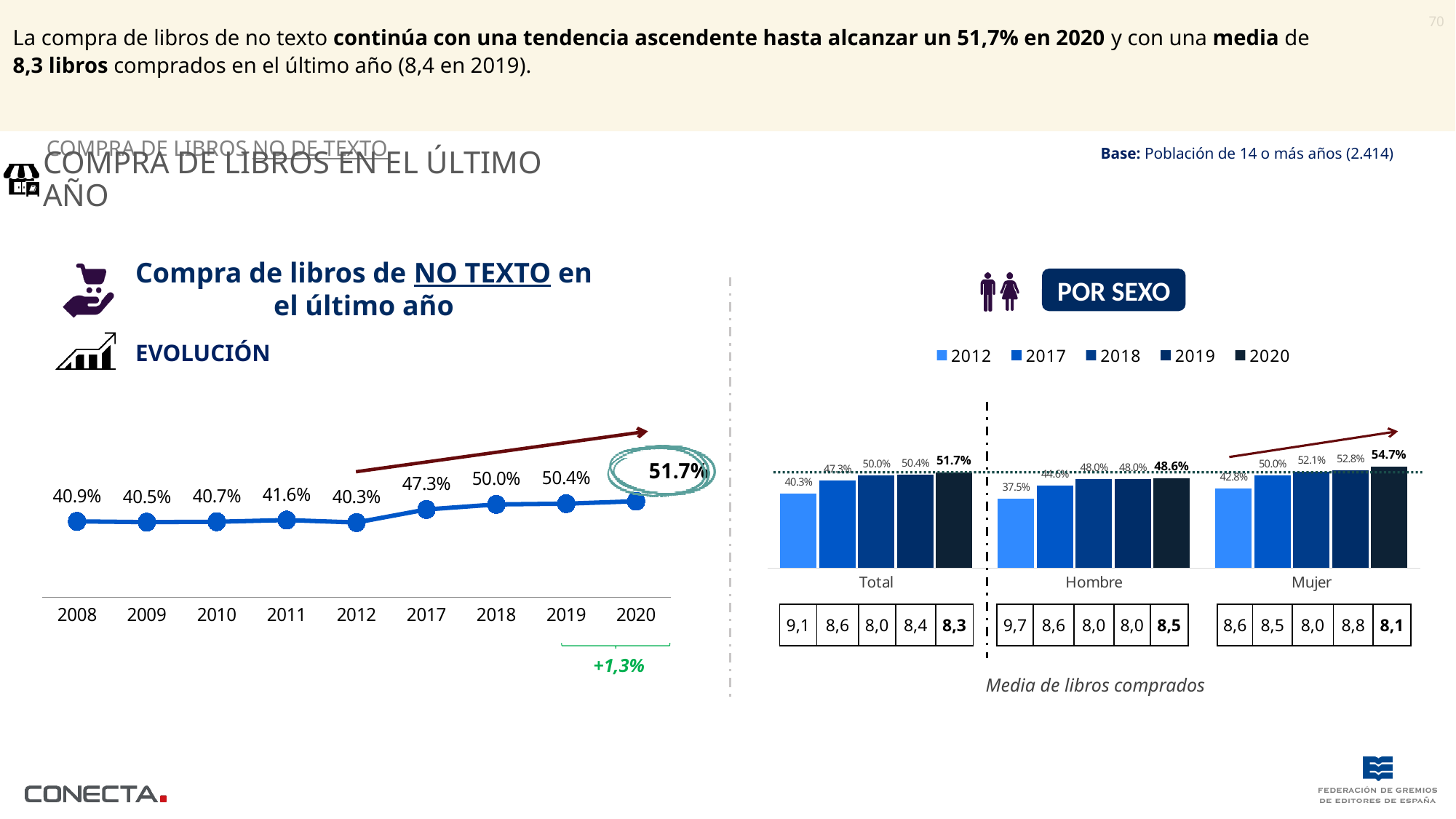
In the POR SEXO bar chart, what is the 2020 value for Mujer? 54.7% In the EVOLUCIÓN line chart, what is the value for 2012? 40.3% What kind of chart is the EVOLUCIÓN chart on the left? Line chart In the EVOLUCIÓN line chart, do the values rise or fall from 2012 to 2020? Rise In the EVOLUCIÓN line chart, what is the value for 2020? 51.7% In the POR SEXO bar chart, how many series does the legend list? 5 In the EVOLUCIÓN line chart, which year has the highest value? 2020 In the EVOLUCIÓN line chart, which year has the lowest value? 2012 In the EVOLUCIÓN line chart, what is the difference between the 2020 and 2019 values? 1.3% In the POR SEXO bar chart, which is larger for 2020: Hombre or Mujer? Mujer In the POR SEXO bar chart, what is the 2012 value for Hombre? 37.5% In the EVOLUCIÓN line chart, how many years are plotted on the x axis? 9